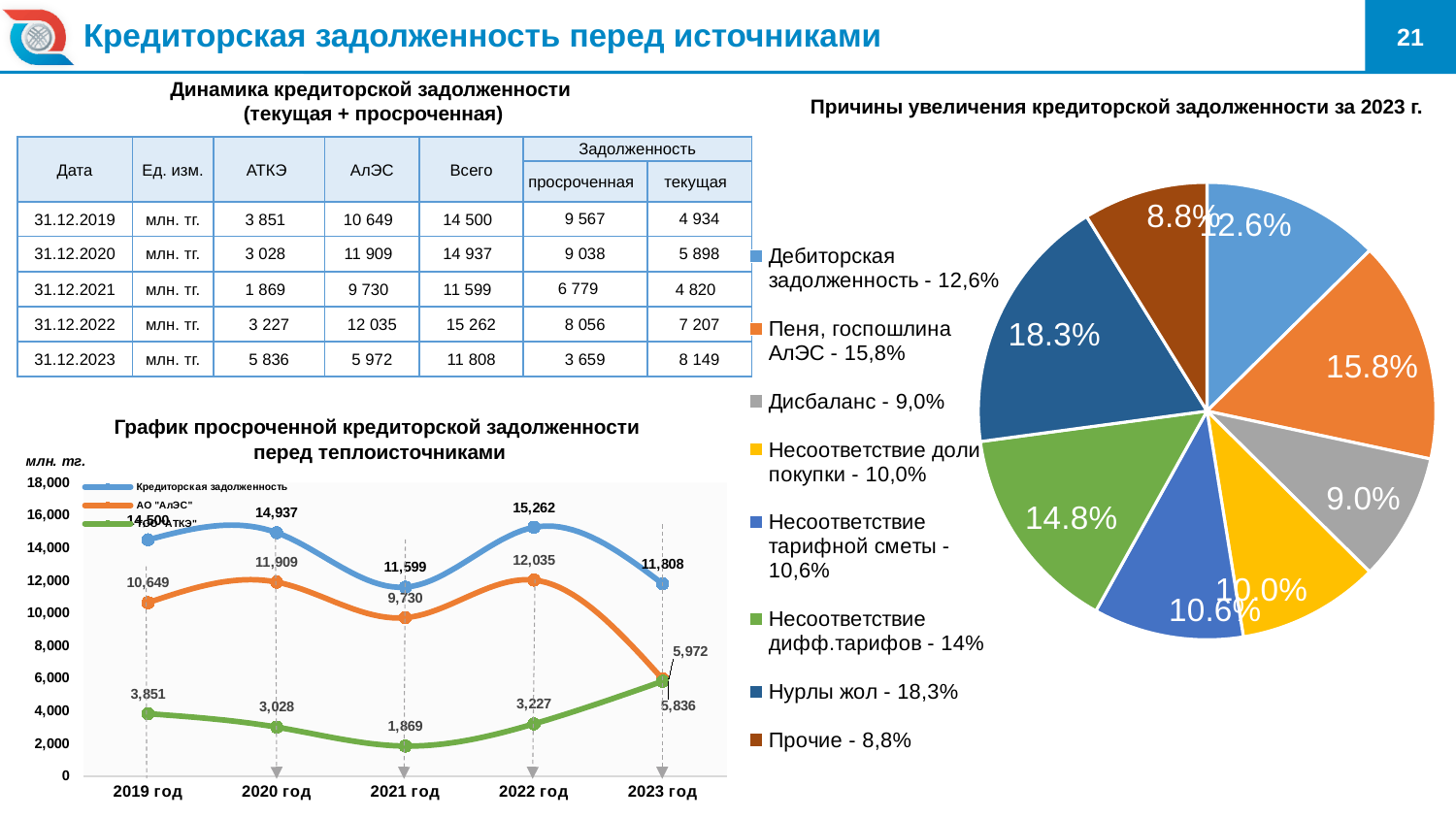
In the pie chart 'Причины увеличения кредиторской задолженности за 2023 г.', what is the share of 'Пеня, госпошлина АлЭС'? 15,8% In the line chart 'График просроченной кредиторской задолженности перед теплоисточниками', which is larger in 2023 год: the АО "АлЭС" value or the green series value? АО "АлЭС" In the line chart 'График просроченной кредиторской задолженности перед теплоисточниками', what is the value of the 'Кредиторская задолженность' series for 2022 год? 15,262 In the line chart 'График просроченной кредиторской задолженности перед теплоисточниками', in which year is the green series lowest? 2021 год In the line chart 'График просроченной кредиторской задолженности перед теплоисточниками', what is the value of the АО "АлЭС" series for 2023 год? 5,972 In the pie chart 'Причины увеличения кредиторской задолженности за 2023 г.', how many categories does the legend list? 8 In the pie chart 'Причины увеличения кредиторской задолженности за 2023 г.', which category has the largest share? Нурлы жол In the line chart 'График просроченной кредиторской задолженности перед теплоисточниками', how many years are shown on the x axis? 5 In the line chart 'График просроченной кредиторской задолженности перед теплоисточниками', how many series does the legend list? 3 What kind of chart is 'График просроченной кредиторской задолженности перед теплоисточниками'? Line chart In the line chart 'График просроченной кредиторской задолженности перед теплоисточниками', what is the difference between the 'Кредиторская задолженность' values for 2020 год and 2021 год? 3,338 In the line chart 'График просроченной кредиторской задолженности перед теплоисточниками', in which year is the 'Кредиторская задолженность' series highest? 2022 год